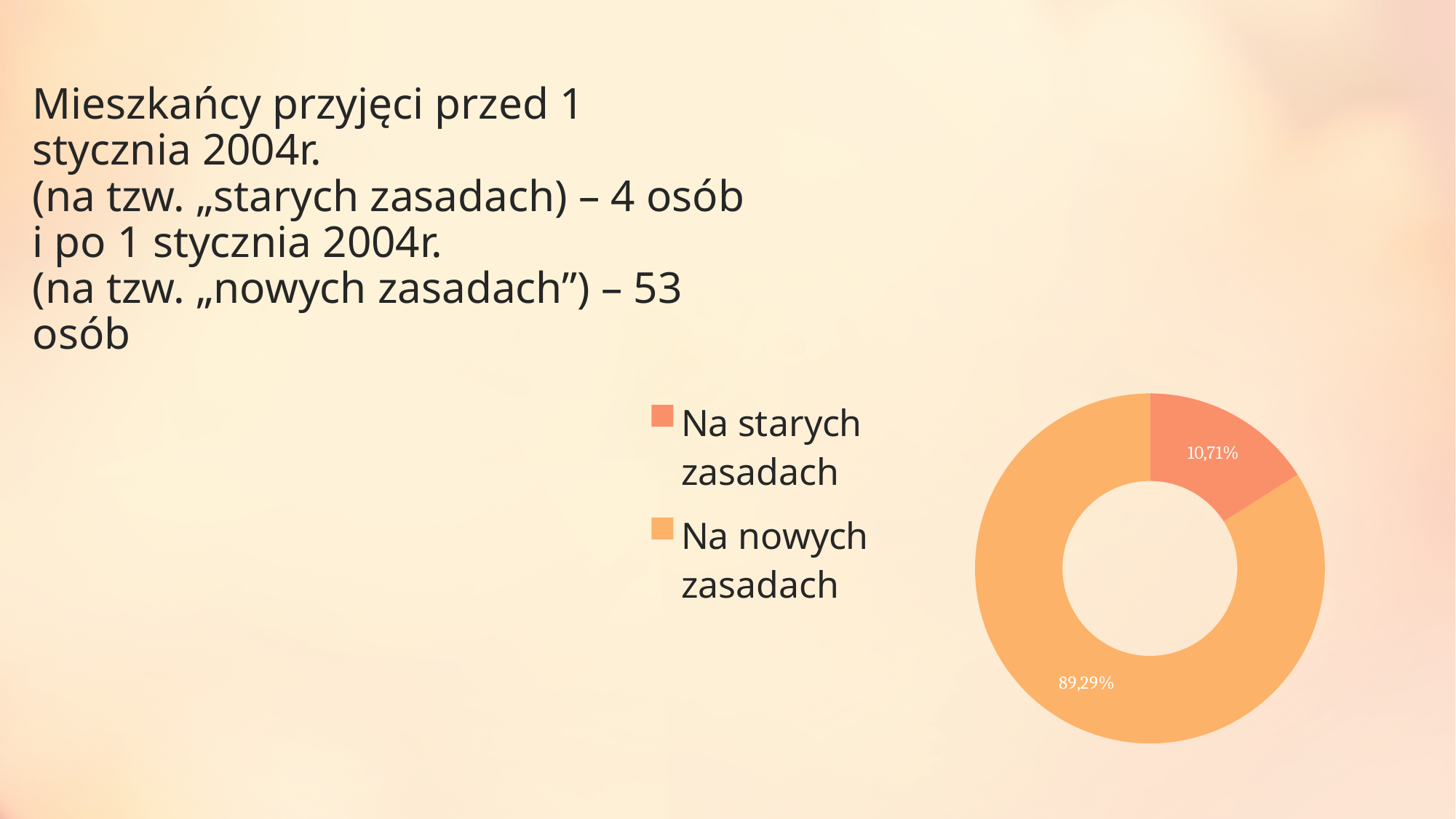
Which category has the largest share of the doughnut chart? Na nowych zasadach Where is the legend positioned relative to the doughnut chart? To the left of the chart What kind of chart is shown on the slide? Doughnut chart What percentage is shown for "Na nowych zasadach"? 89,29% How many entries does the legend list? 2 Which category has the smallest share of the doughnut chart? Na starych zasadach What percentage is shown for "Na starych zasadach"? 10,71% What is the difference in percentage points between "Na nowych zasadach" and "Na starych zasadach"? 78,58 What colour is the "Na starych zasadach" slice? Orange (darker/salmon orange) How many categories does the doughnut chart show? 2 Which is larger: the share for "Na starych zasadach" or "Na nowych zasadach"? Na nowych zasadach